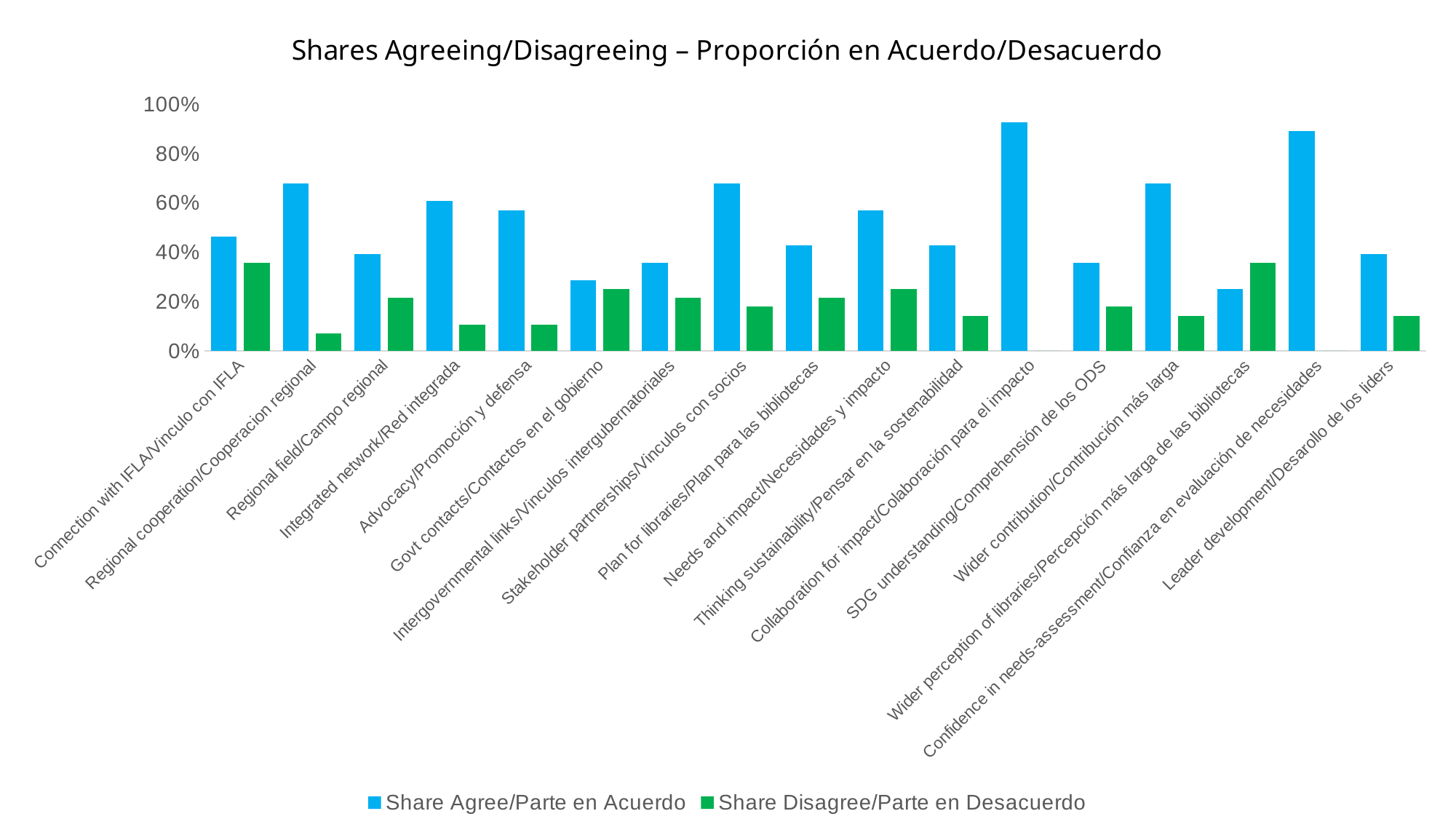
Is the Share Agree value for Stakeholder partnerships/Vinculos con socios greater or less than 60%? greater How many categories are shown on the x axis? 17 Which colour represents the Share Disagree/Parte en Desacuerdo series? green Which is larger for Wider perception of libraries/Percepción más larga de las bibliotecas: the Share Agree value or the Share Disagree value? Share Disagree Is the Share Disagree value for Regional cooperation/Cooperacion regional greater or less than 20%? less What is the title of the chart? Shares Agreeing/Disagreeing – Proporción en Acuerdo/Desacuerdo Which category has the highest Share Agree/Parte en Acuerdo value? Collaboration for impact/Colaboración para el impacto How many series does the legend list? 2 What type of chart is shown on the slide? bar chart Is the Share Agree value for Collaboration for impact/Colaboración para el impacto greater or less than 80%? greater Which category has the larger Share Agree value: Regional cooperation/Cooperacion regional or Regional field/Campo regional? Regional cooperation/Cooperacion regional